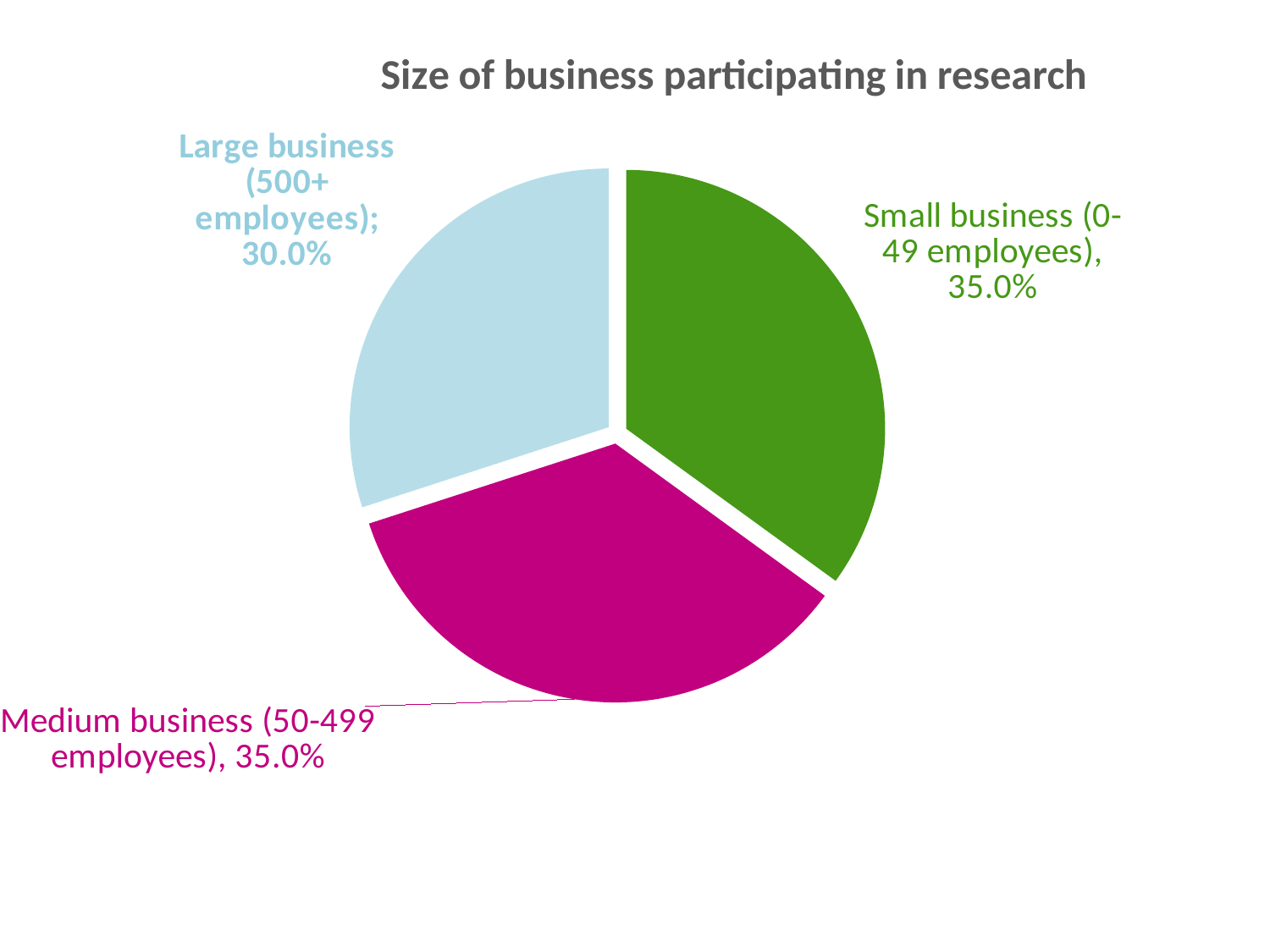
Which business size has the smallest share of the pie? Large business (500+ employees) What is the difference between the share for Small business (0-49 employees) and the share for Large business (500+ employees)? 5.0% Which is larger, the share for Medium business (50-499 employees) or the share for Large business (500+ employees)? Medium business (50-499 employees) How many slices does the pie chart have? 3 What share of the pie is Large business (500+ employees)? 30.0% What is the title of the chart? Size of business participating in research What share of the pie is Medium business (50-499 employees)? 35.0% What is the combined share of Small business (0-49 employees) and Medium business (50-499 employees)? 70.0% What kind of chart is shown on the slide? Pie chart What share of the pie is Small business (0-49 employees)? 35.0% What colour is the slice for Small business (0-49 employees)? Green